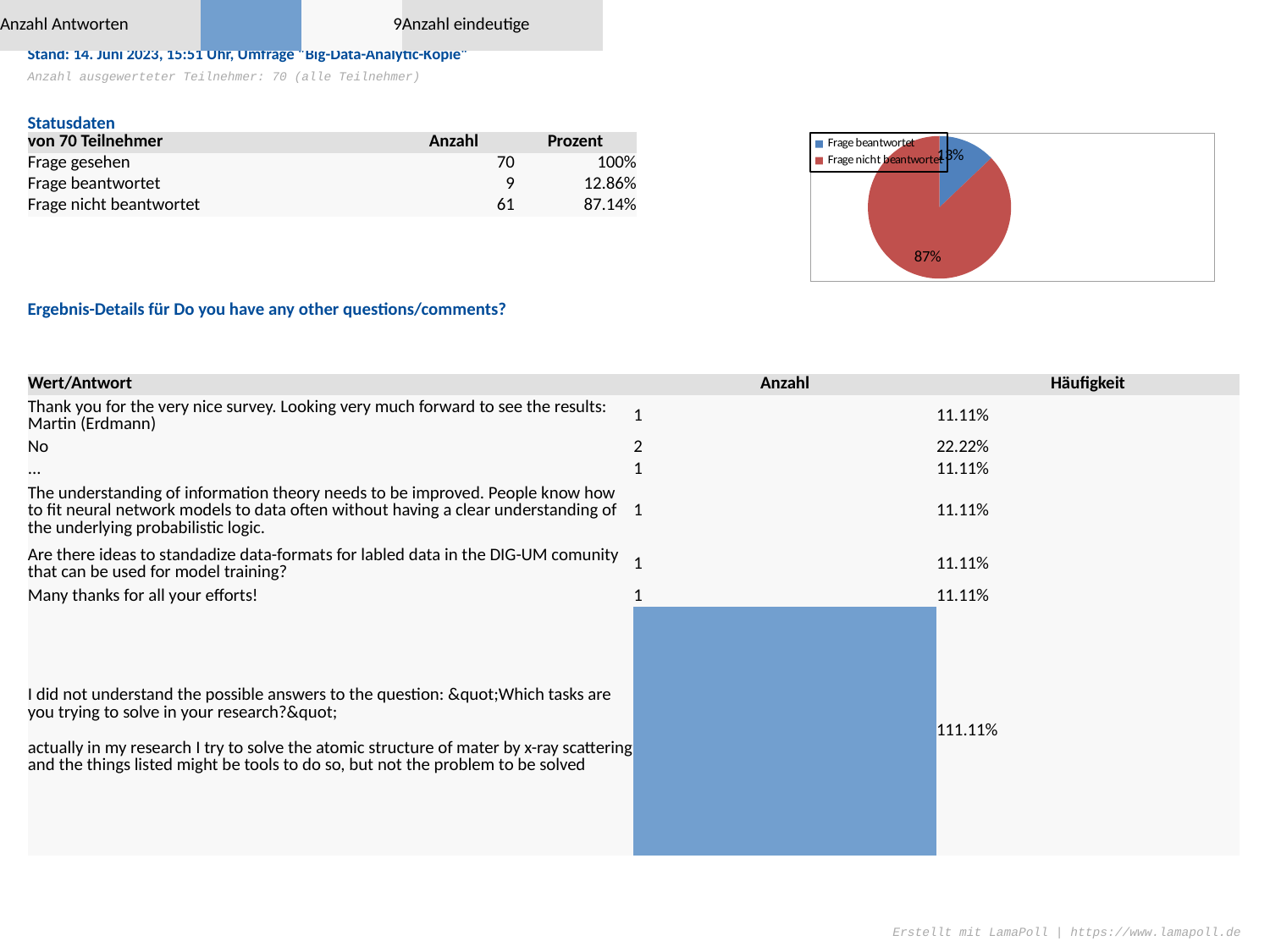
Which category has the smallest slice in the pie chart? Frage beantwortet What colour is the "Frage nicht beantwortet" slice in the pie chart? red How many slices does the pie chart have? 2 In the pie chart, which slice is larger: "Frage beantwortet" or "Frage nicht beantwortet"? Frage nicht beantwortet What colour is the "Frage beantwortet" slice in the pie chart? blue Which category has the largest slice in the pie chart? Frage nicht beantwortet What share of the pie does the red slice represent? 87% What percentage is shown on the pie chart for "Frage nicht beantwortet"? 87% What kind of chart is shown on the slide? pie chart How many entries does the legend of the pie chart list? 2